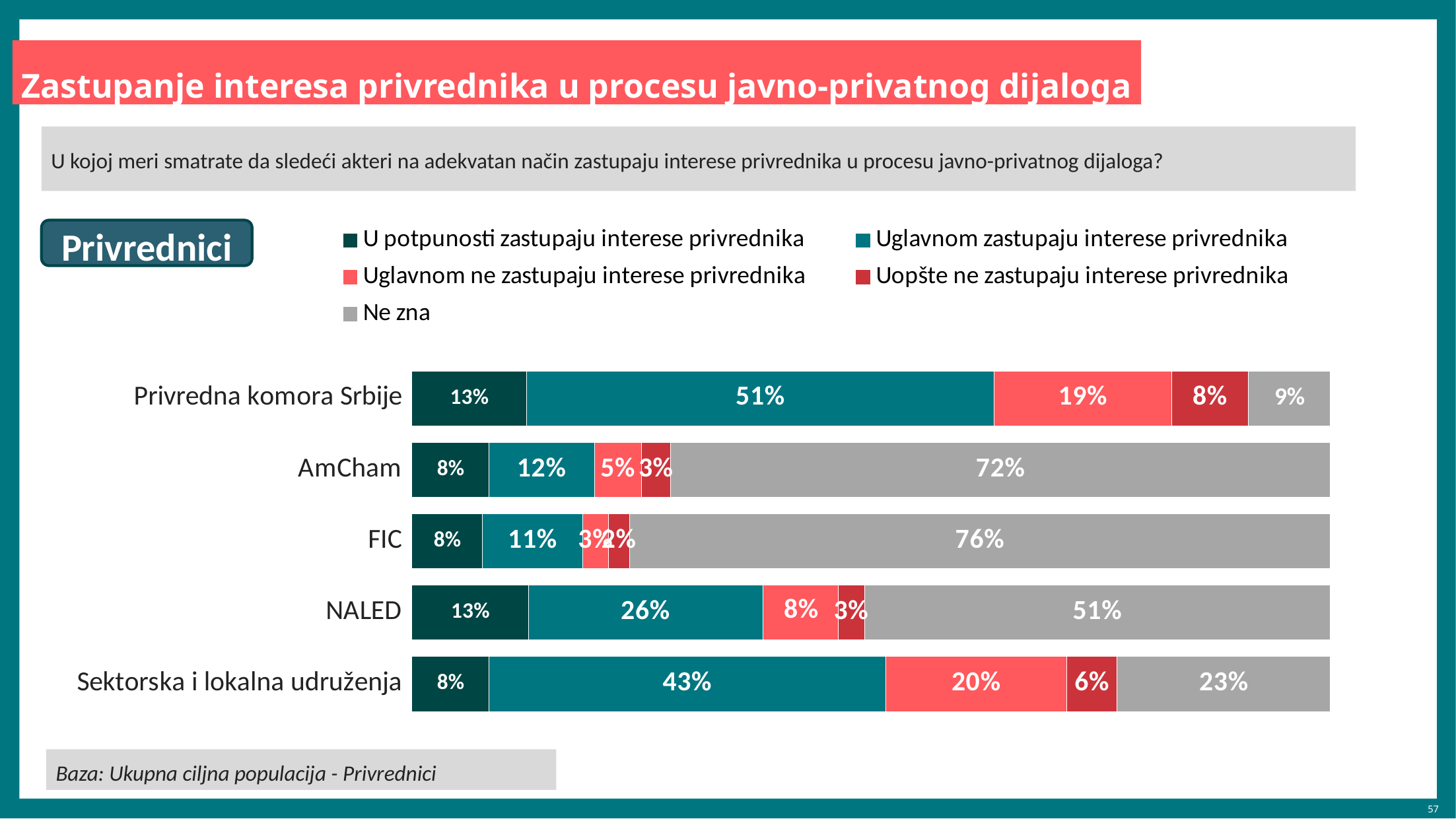
Which is larger: the 'Uopšte ne zastupaju interese privrednika' value for Privredna komora Srbije or for Sektorska i lokalna udruženja? Privredna komora Srbije How many series does the legend list? 5 What type of chart is shown on the slide? Stacked bar chart What colour represents 'Ne zna' in the legend? Grey What is the 'U potpunosti zastupaju interese privrednika' value for NALED? 13% What is the difference between the 'Uglavnom zastupaju interese privrednika' values for Privredna komora Srbije and NALED? 25 percentage points How many categories (actors) are shown on the chart? 5 What is the 'Ne zna' value for FIC? 76% Which actor has the highest 'Ne zna' value? FIC What is the 'Uglavnom ne zastupaju interese privrednika' value for Sektorska i lokalna udruženja? 20% What is the value of 'Uglavnom zastupaju interese privrednika' for Privredna komora Srbije? 51% Which actor has the lowest 'Ne zna' value? Privredna komora Srbije